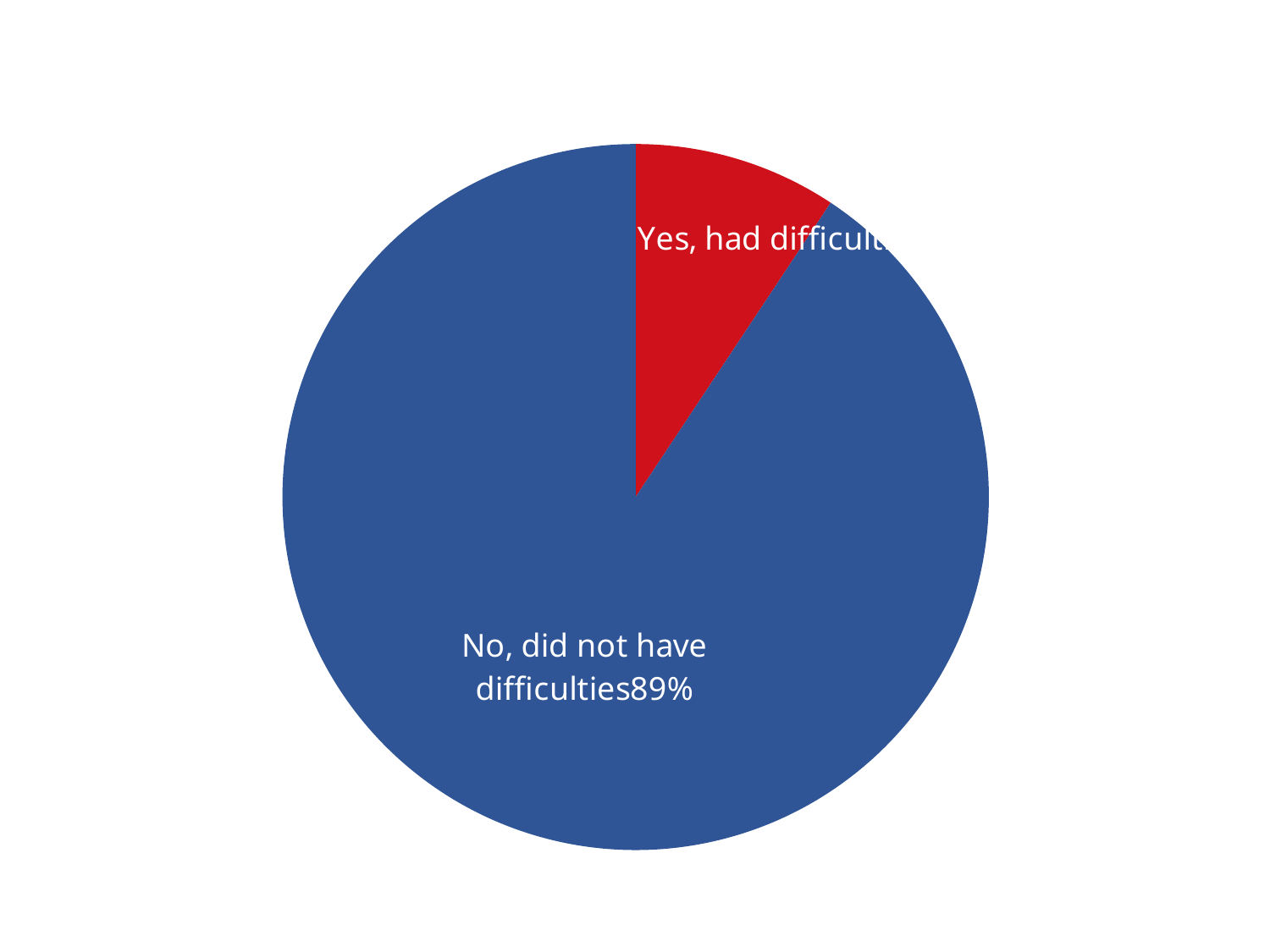
Which is larger: the "No, did not have difficulties" slice or the "Yes, had difficulties" slice? No, did not have difficulties What kind of chart is shown on the slide? pie chart What share of the pie does the "No, did not have difficulties" slice represent? 89% What colour is the "No, did not have difficulties" slice? blue What colour is the smaller slice of the pie chart? red How many slices does the pie chart have? 2 Which slice of the pie chart is the largest? No, did not have difficulties